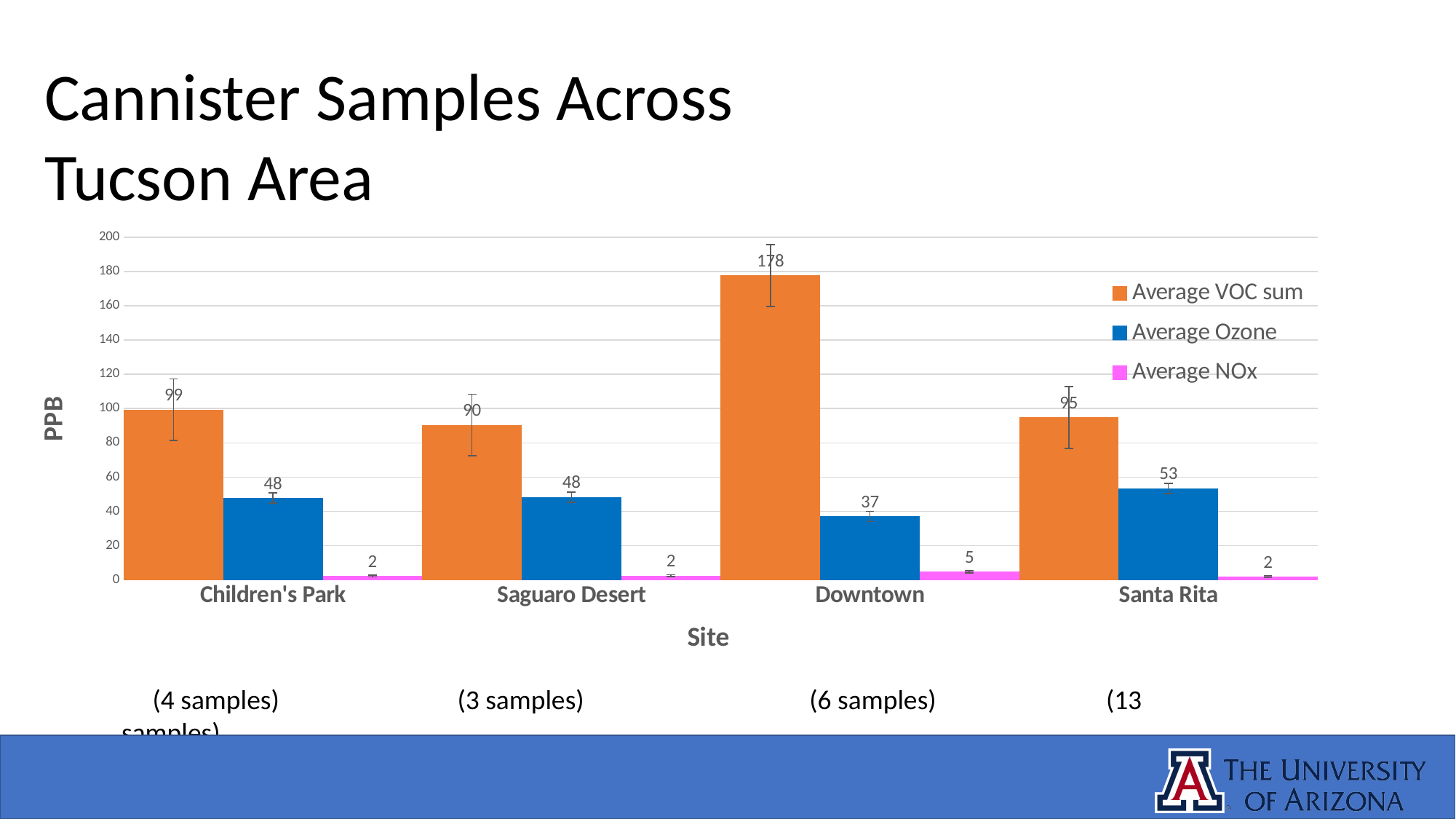
What kind of chart is shown on the slide? bar chart Which site has the highest Average VOC sum? Downtown How many series does the legend list? 3 What is the label of the y axis? PPB How many sites are shown on the x axis? 4 What is the Average Ozone value for Santa Rita? 53 What is the Average NOx value for Downtown? 5 Is the Average VOC sum for Santa Rita greater or less than 80? greater What is the Average VOC sum value for Downtown? 178 What is the difference between the Average VOC sum for Downtown and for Children's Park? 79 Which site has the lowest Average Ozone? Downtown Which is larger, the Average VOC sum for Children's Park or for Saguaro Desert? Children's Park